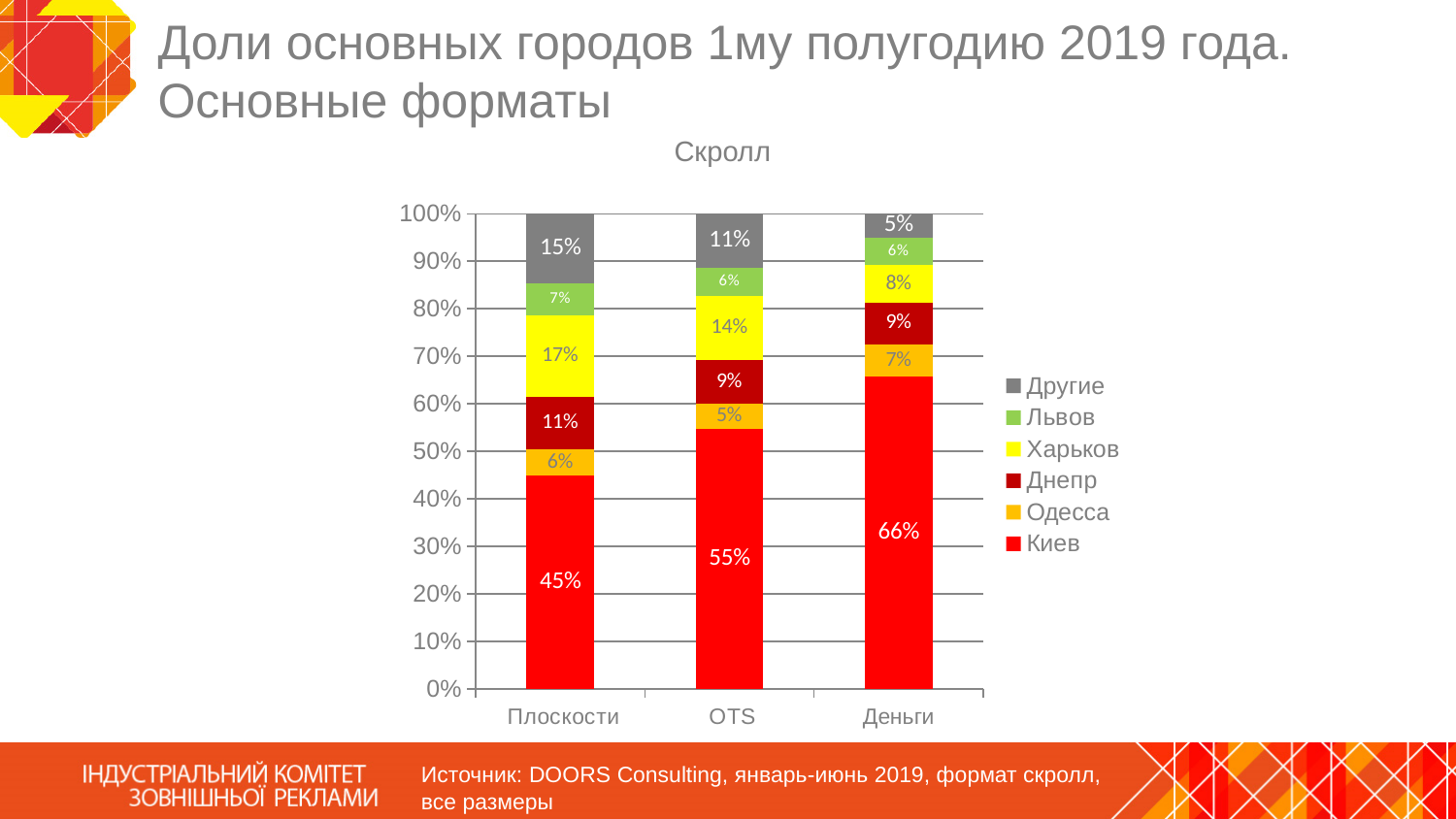
What is the title of the chart? Скролл How many series does the legend list? 6 How many categories are shown on the x axis? 3 What kind of chart is shown on the slide? Stacked bar chart Which category has the lowest value for Другие? Деньги What is the value for Другие in the Деньги bar? 5% What is the difference between the Киев values for Деньги and Плоскости? 21% Which is larger: Харьков in Плоскости or Харьков in Деньги? Харьков in Плоскости Which category has the highest value for Киев? Деньги What is the value for Днепр in the Плоскости bar? 11% What is the value for Киев in the Плоскости bar? 45% What is the value for Харьков in the OTS bar? 14%